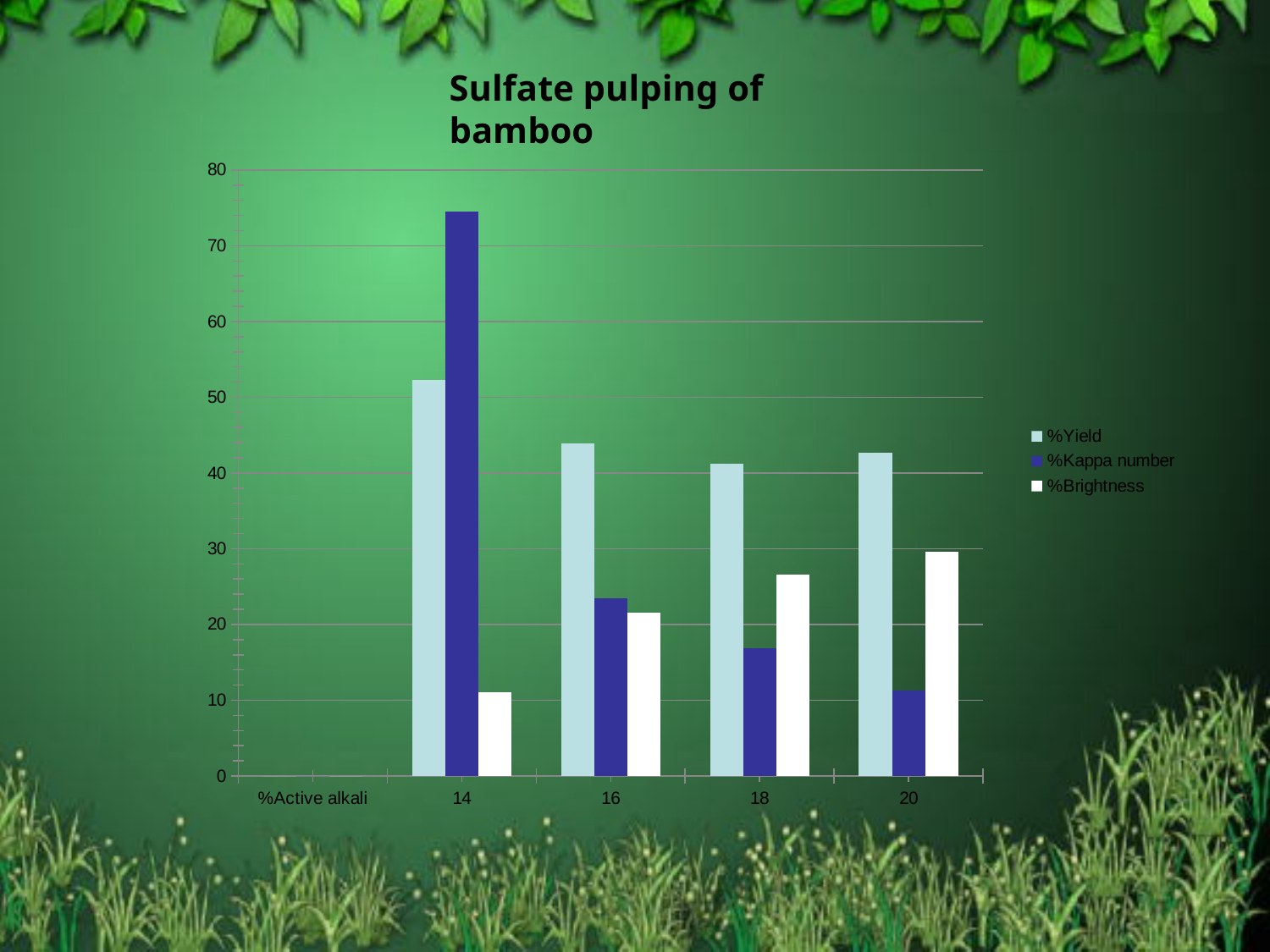
How many active alkali levels have bars plotted? 4 What is the title of the chart? Sulfate pulping of bamboo At active alkali 18, which is larger, %Brightness or %Kappa number? %Brightness How many series does the legend list? 3 Is the %Kappa number at active alkali 20 greater or less than 20? less Does the %Kappa number rise or fall as active alkali increases from 14 to 20? fall What kind of chart is shown on the slide? bar chart At which active alkali level is the %Kappa number highest? 14 At which active alkali level is the %Brightness lowest? 14 Which series is shown in white in the legend? %Brightness At which active alkali level is the %Brightness highest? 20 Is the %Kappa number at active alkali 14 greater or less than 70? greater